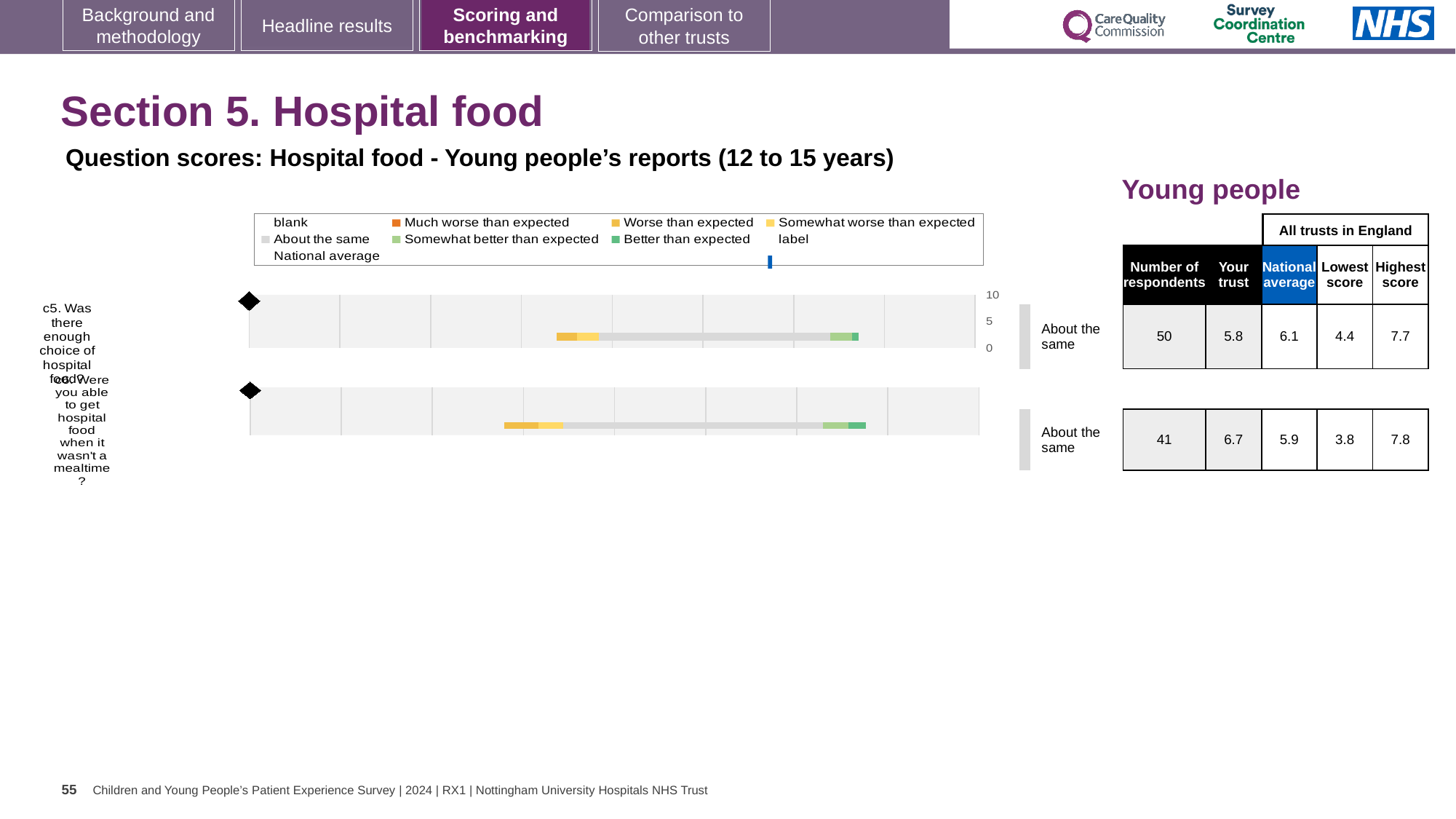
For question c5, is the 'Your trust' score larger or smaller than the national average? smaller What is the highest value shown on the chart's axis? 10 How many respondents answered question c5? 50 What is the difference between the highest score and the lowest score for question c5? 3.3 According to the table, what is the national average for question c6 (Were you able to get hospital food when it wasn't a mealtime?)? 5.9 Which legend entry is shown with a dark grey/light grey colour and labelled 'About the same'? About the same According to the table, what is the 'Your trust' score for question c5 (Was there enough choice of hospital food?)? 5.8 What kind of chart is shown on the slide? bar chart For question c6, is the 'Your trust' score larger or smaller than the national average? larger How many respondents answered question c6? 41 What benchmark category is given for both c5 and c6? About the same How many questions (bars) are plotted in the chart? 2